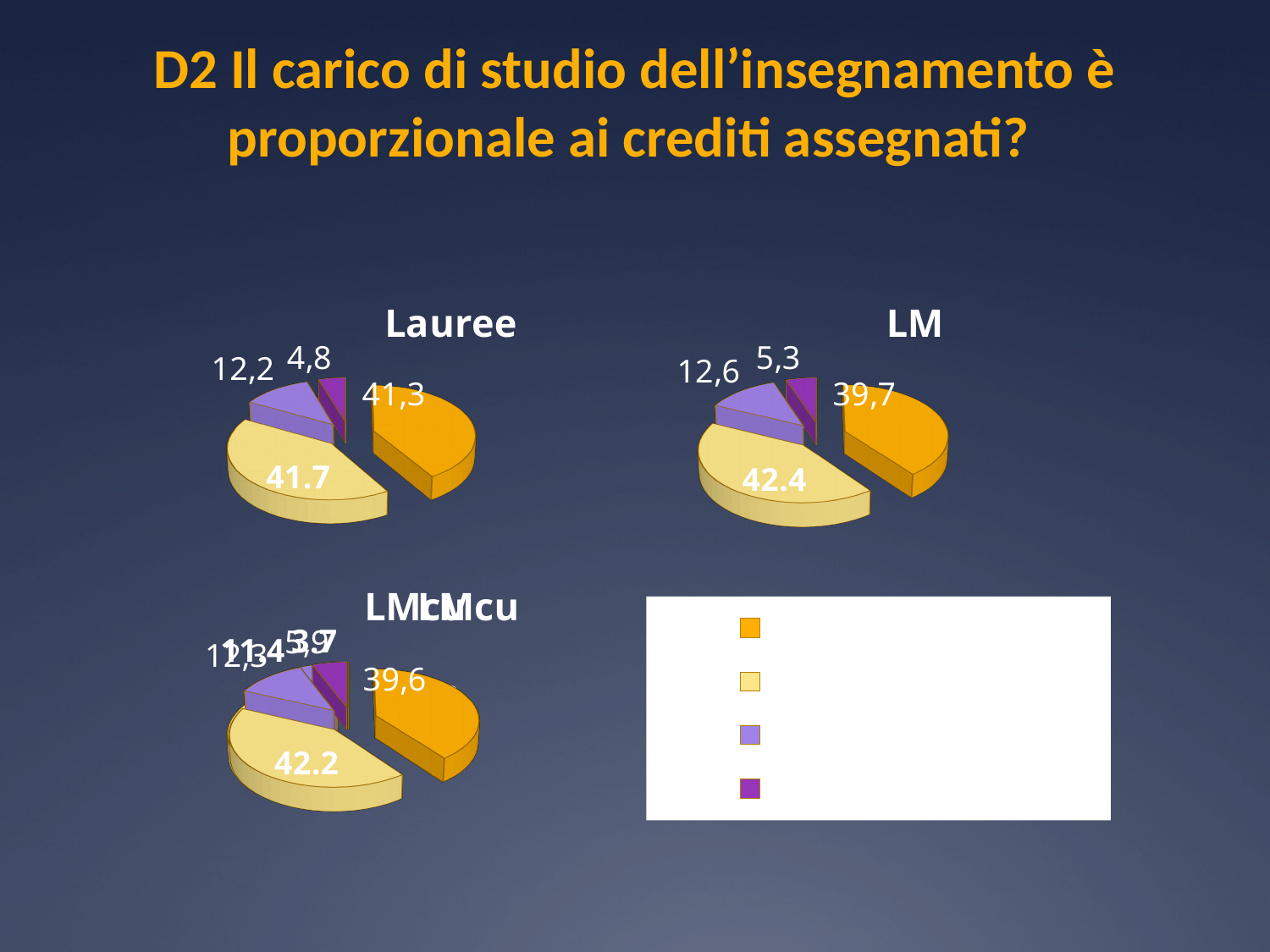
In the Lauree chart, what value is shown for the dark purple slice? 4,8 How many slices does the Lauree pie chart have? 4 In the LM chart, which slice has the largest value? The light yellow slice (42.4) In the LM chart, what value is shown for the light yellow slice? 42.4 In the Lauree chart, what value is shown for the orange slice? 41,3 What kind of charts are shown on the slide? Pie charts In the LM chart, which slice has the smallest value? The dark purple slice (5,3) In the Lauree chart, what value is shown for the light yellow slice? 41.7 In the LM chart, what is the difference between the light yellow slice (42.4) and the orange slice (39,7)? 2.7 How many colour swatches does the legend box on the slide show? 4 In the LM chart, what value is shown for the light purple slice? 12,6 In the Lauree chart, which is larger: the light purple slice or the dark purple slice? The light purple slice (12,2)